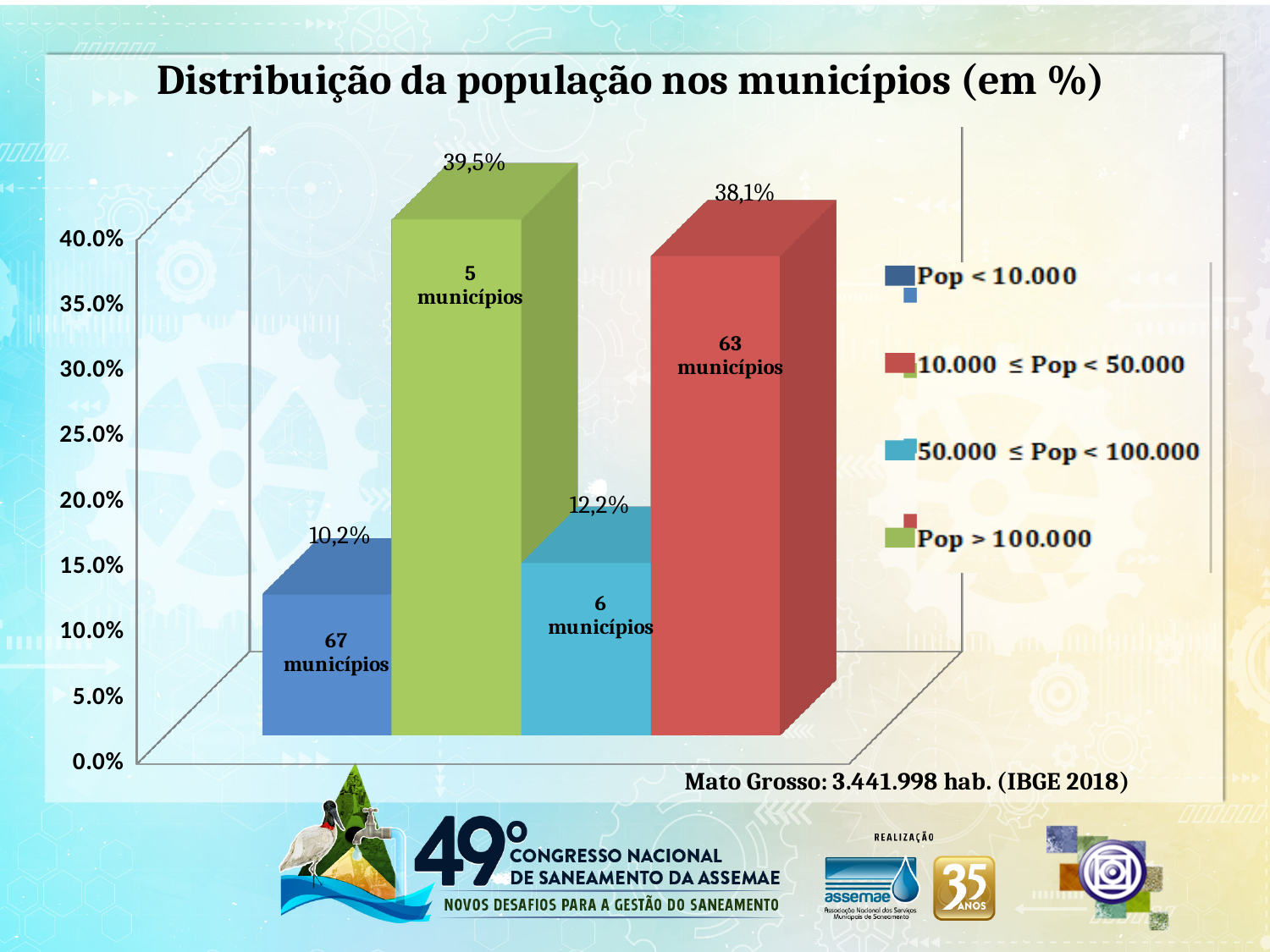
What is the value for 50.000 ≤ Pop < 100.000? 12,2% What is the difference between the values for Pop > 100.000 and 10.000 ≤ Pop < 50.000? 1,4% What is the value for 10.000 ≤ Pop < 50.000? 38,1% How many municípios are in the Pop > 100.000 category? 5 municípios How many entries does the legend list? 4 What is the value for Pop > 100.000? 39,5% What kind of chart is shown on the slide? Bar chart Which is larger, the value for 50.000 ≤ Pop < 100.000 or the value for Pop < 10.000? 50.000 ≤ Pop < 100.000 Which category has the lowest percentage? Pop < 10.000 Which category has the highest percentage? Pop > 100.000 What is the value for Pop < 10.000? 10,2% How many municípios are in the Pop < 10.000 category? 67 municípios